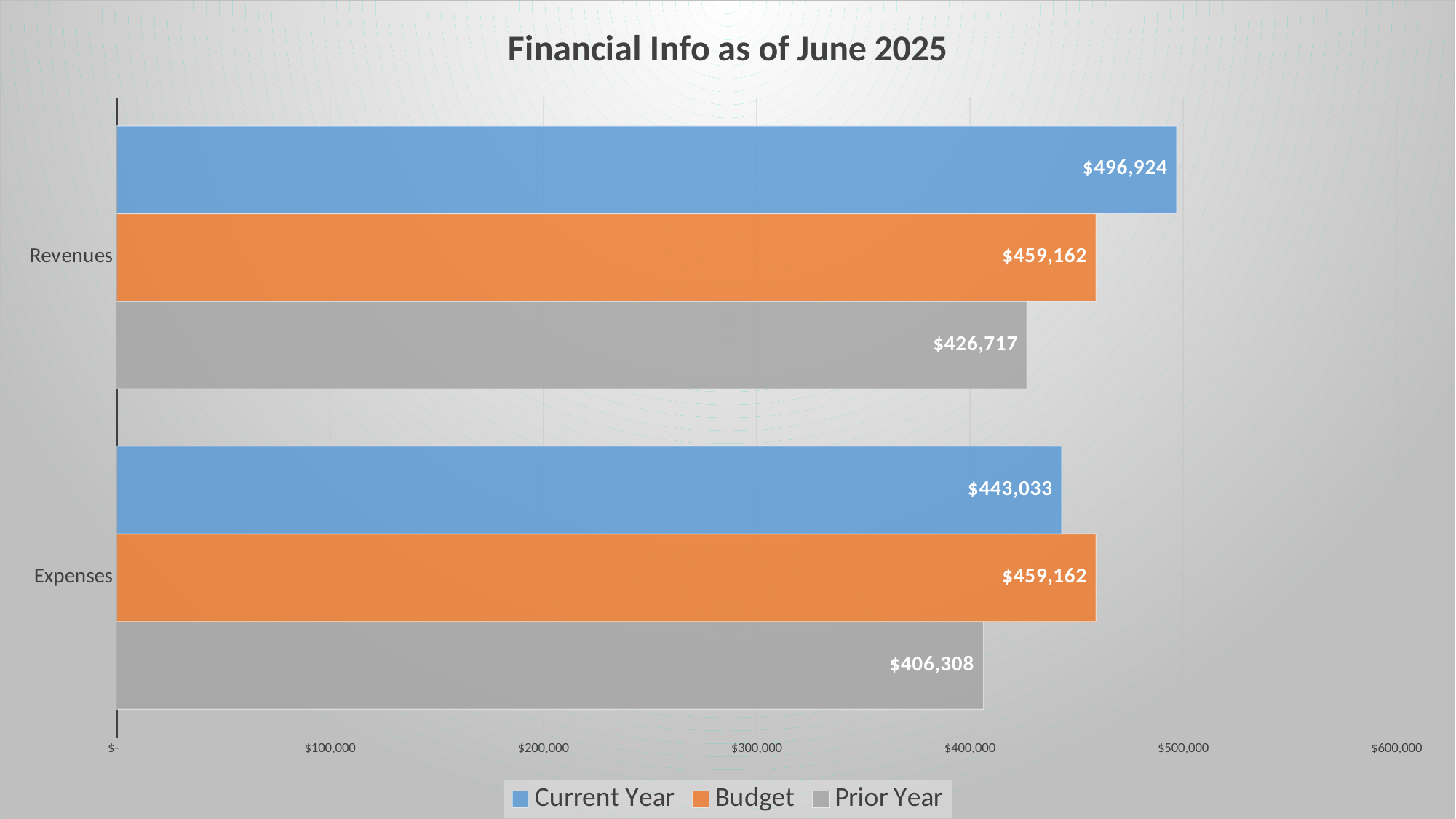
What kind of chart is shown on the slide? Bar chart What is the Budget value for Revenues? $459,162 Which series has the highest value for Revenues? Current Year How many series does the legend list? 3 What is the Prior Year value for Expenses? $406,308 What is the Current Year value for Revenues? $496,924 What is the Current Year value for Expenses? $443,033 Which is larger, the Prior Year value for Revenues or the Prior Year value for Expenses? Revenues How many categories are shown on the chart? 2 What is the title of the chart? Financial Info as of June 2025 Which series has the lowest value for Expenses? Prior Year What is the difference between the Current Year Revenues and the Current Year Expenses? $53,891